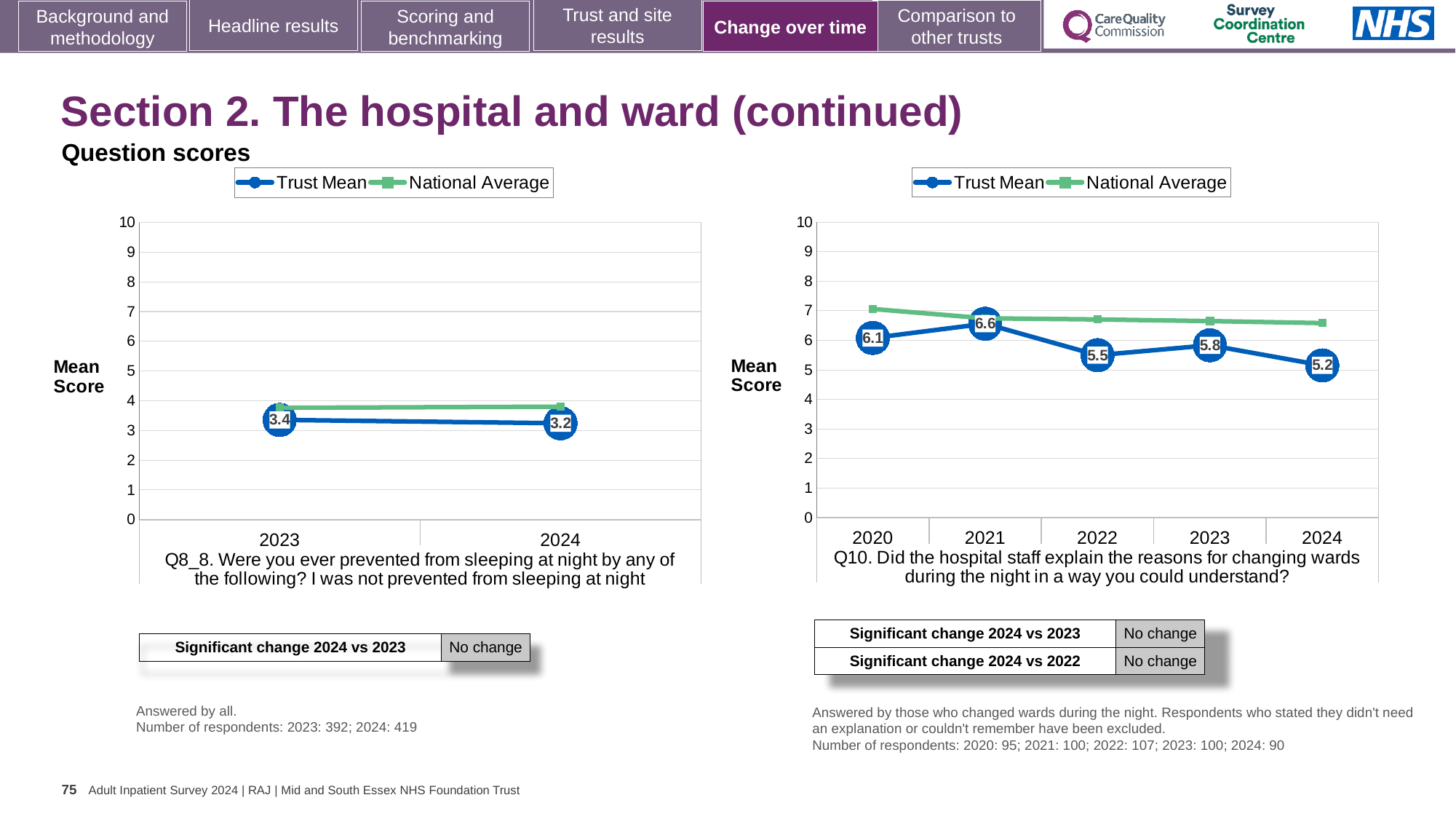
In the right chart (Q10), what is the difference between the Trust Mean scores for 2021 and 2022? 1.1 In the left chart (Q8_8), what is the Trust Mean score for 2023? 3.4 In the right chart (Q10), which year has the lowest Trust Mean score? 2024 In the left chart (Q8_8), what is the Trust Mean score for 2024? 3.2 In the right chart (Q10), which year has the highest Trust Mean score? 2021 In the right chart (Q10), what is the Trust Mean score for 2021? 6.6 In the right chart (Q10), is the Trust Mean for 2023 higher or lower than the Trust Mean for 2022? higher In the left chart (Q8_8), by how much did the Trust Mean change from 2023 to 2024? 0.2 In the right chart (Q10), what is the Trust Mean score for 2024? 5.2 How many years are plotted on the x axis of the right chart (Q10)? 5 In the left chart (Q8_8), is the National Average for 2024 greater or less than 4? less